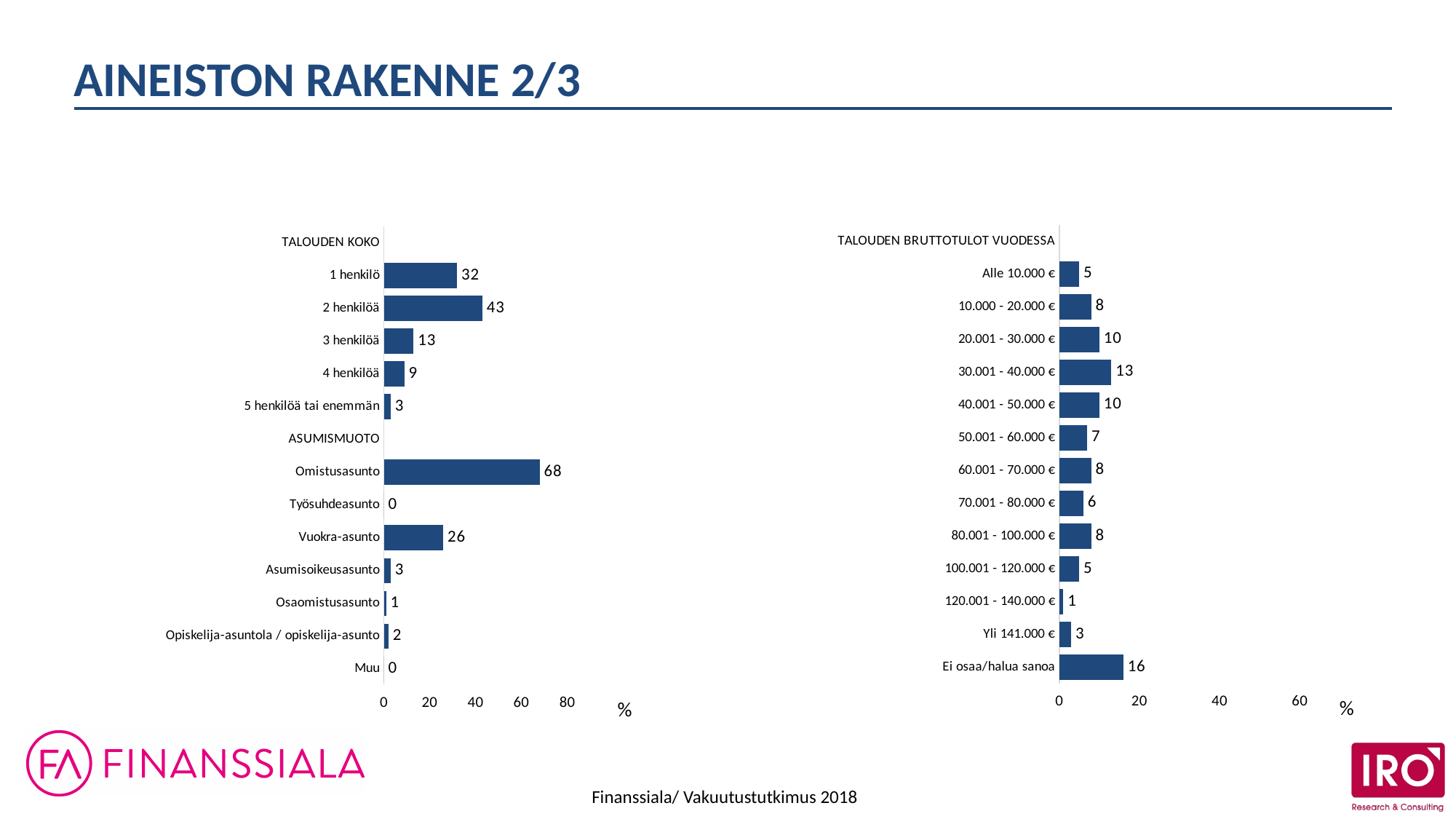
What kind of chart is the right chart (TALOUDEN BRUTTOTULOT VUODESSA)? Bar chart In the right chart (TALOUDEN BRUTTOTULOT VUODESSA), what is the difference between the values for Ei osaa/halua sanoa and Alle 10.000 €? 11 In the right chart (TALOUDEN BRUTTOTULOT VUODESSA), what is the value for 30.001 - 40.000 €? 13 In the left chart (TALOUDEN KOKO / ASUMISMUOTO), which category has the highest value? Omistusasunto In the right chart (TALOUDEN BRUTTOTULOT VUODESSA), which category has the lowest value? 120.001 - 140.000 € In the left chart (TALOUDEN KOKO / ASUMISMUOTO), what is the difference between the values for 1 henkilö and 3 henkilöä? 19 In the left chart (TALOUDEN KOKO / ASUMISMUOTO), what is the value for Vuokra-asunto? 26 In the right chart (TALOUDEN BRUTTOTULOT VUODESSA), what is the value for Ei osaa/halua sanoa? 16 In the left chart (TALOUDEN KOKO / ASUMISMUOTO), what is the value for 2 henkilöä? 43 In the left chart (TALOUDEN KOKO / ASUMISMUOTO), which is larger, the value for 4 henkilöä or the value for 5 henkilöä tai enemmän? 4 henkilöä What unit is shown on the x axis of the left chart (TALOUDEN KOKO / ASUMISMUOTO)? % In the right chart (TALOUDEN BRUTTOTULOT VUODESSA), how many categories are plotted? 13